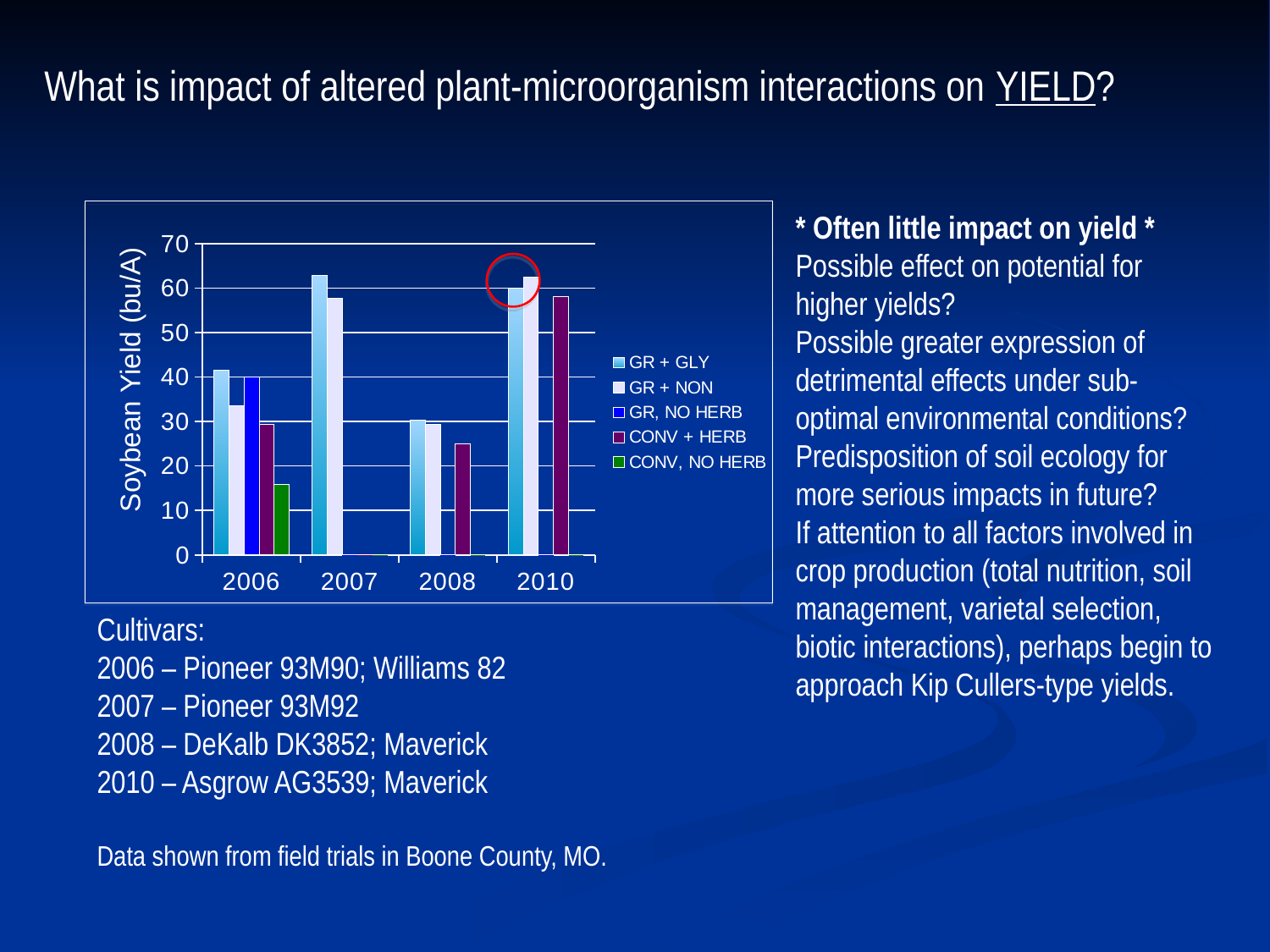
Which series is listed first in the chart's legend? GR + GLY What is the label on the y axis of the chart? Soybean Yield (bu/A) How many series does the chart's legend list? 5 What kind of chart is shown on the slide? bar chart Is the GR + NON value for 2006 greater or less than 40? less Is the CONV + HERB value for 2010 greater or less than 50? greater How many years (categories) are shown on the x axis of the chart? 4 Is the CONV, NO HERB value for 2006 greater or less than 20? less In 2006, which is larger: the GR + GLY value or the CONV, NO HERB value? GR + GLY In which year is the GR + GLY bar the lowest? 2008